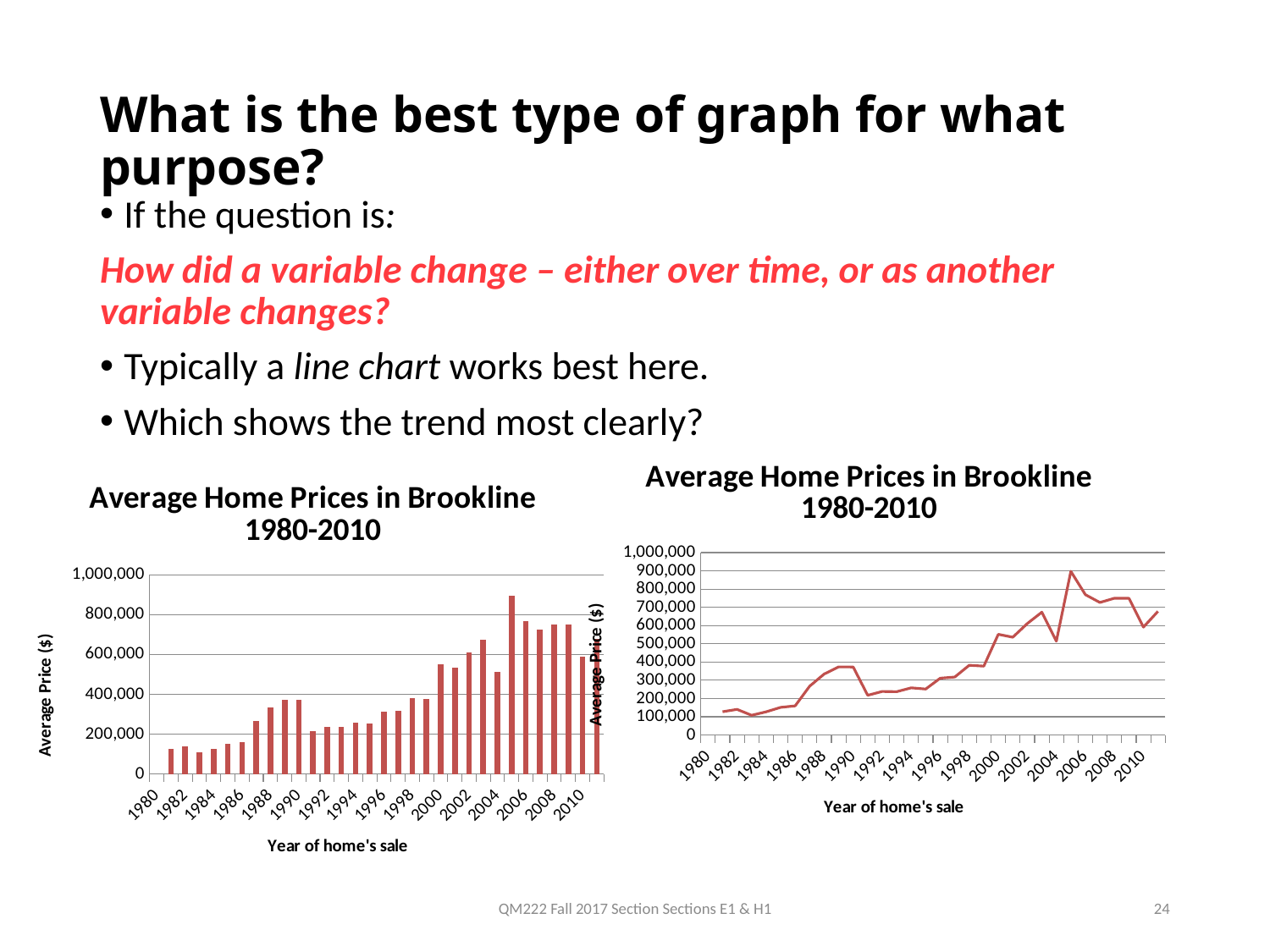
In the bar chart on the left, which year has the highest average home price? 2005 In the line chart on the right, is the value for 2000 greater or less than 400,000? greater What is the x-axis label of the bar chart on the left? Year of home's sale What kind of chart is the chart on the left of the slide? bar chart In the line chart on the right, is the value for 1992 greater or less than 300,000? less In the line chart on the right, do average home prices generally rise or fall from 1980 to 2010? rise In the line chart on the right, which year has the highest average home price? 2005 What kind of chart is the chart on the right of the slide? line chart In the bar chart on the left, is the value for 2005 greater or less than 800,000? greater What is the title of the chart on the right of the slide? Average Home Prices in Brookline 1980-2010